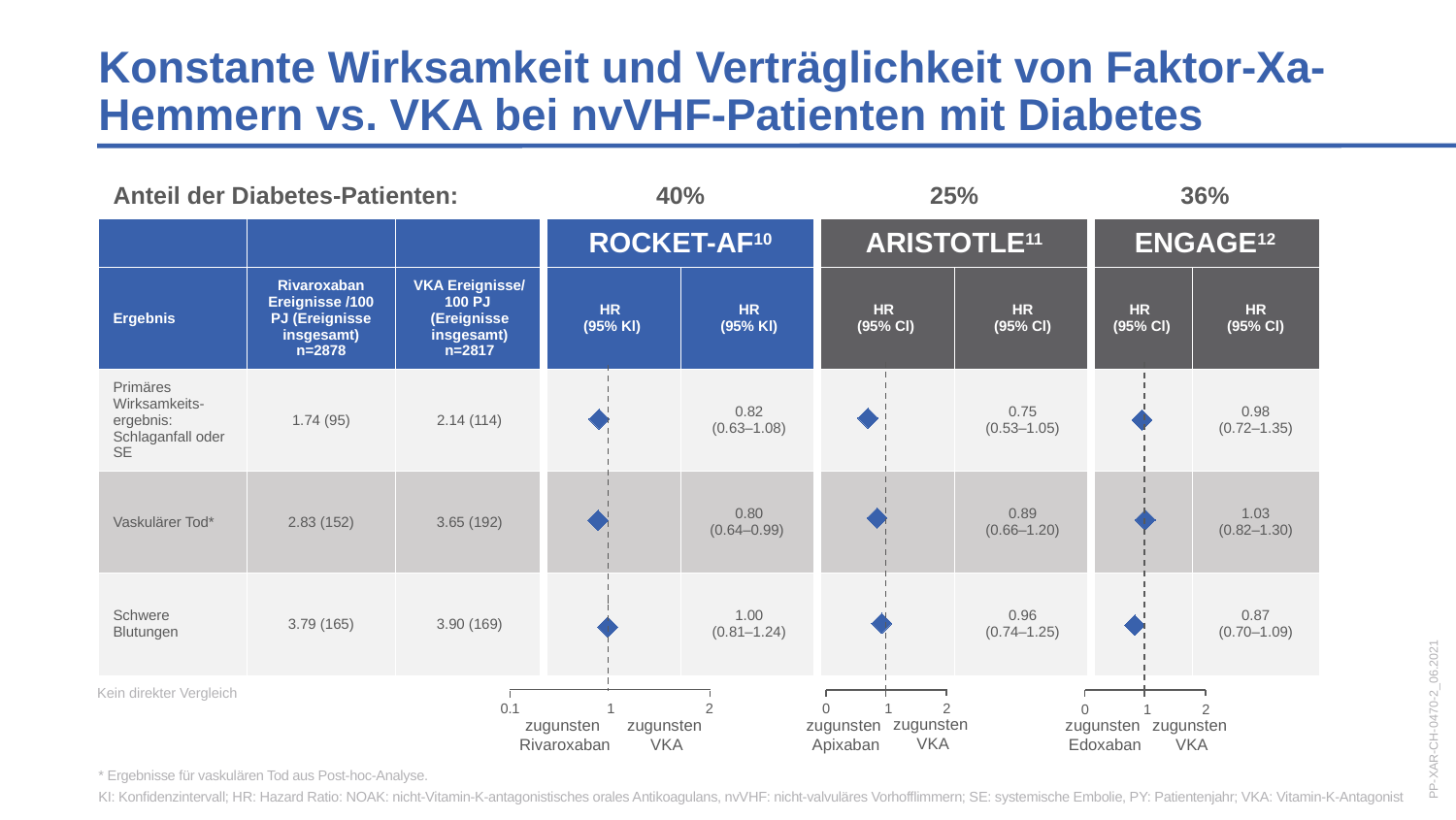
In the ROCKET-AF forest plot, what is the hazard ratio for the primary efficacy endpoint (Schlaganfall oder SE)? 0.82 Across the three forest plots, which study shows the highest hazard ratio for Vaskulärer Tod? ENGAGE What kind of chart is used to display the hazard ratios on this slide? Forest plot In the ENGAGE forest plot, is the hazard ratio for Vaskulärer Tod greater or less than 1? greater Across the three forest plots, which study shows the lowest hazard ratio for the primary efficacy endpoint? ARISTOTLE In the ENGAGE forest plot, what is the hazard ratio for Schwere Blutungen? 0.87 In the ARISTOTLE forest plot, what is the 95% confidence interval for the primary efficacy endpoint? 0.53–1.05 What is the difference between the hazard ratio for Schwere Blutungen in the ROCKET-AF plot and in the ENGAGE plot? 0.13 Which is larger: the hazard ratio for Vaskulärer Tod in the ROCKET-AF plot or in the ARISTOTLE plot? ARISTOTLE In the ROCKET-AF forest plot, what does the left side of the x axis favour according to the axis label? zugunsten Rivaroxaban How many outcomes are plotted in each forest plot? 3 In the ARISTOTLE forest plot, what is the hazard ratio for Vaskulärer Tod? 0.89